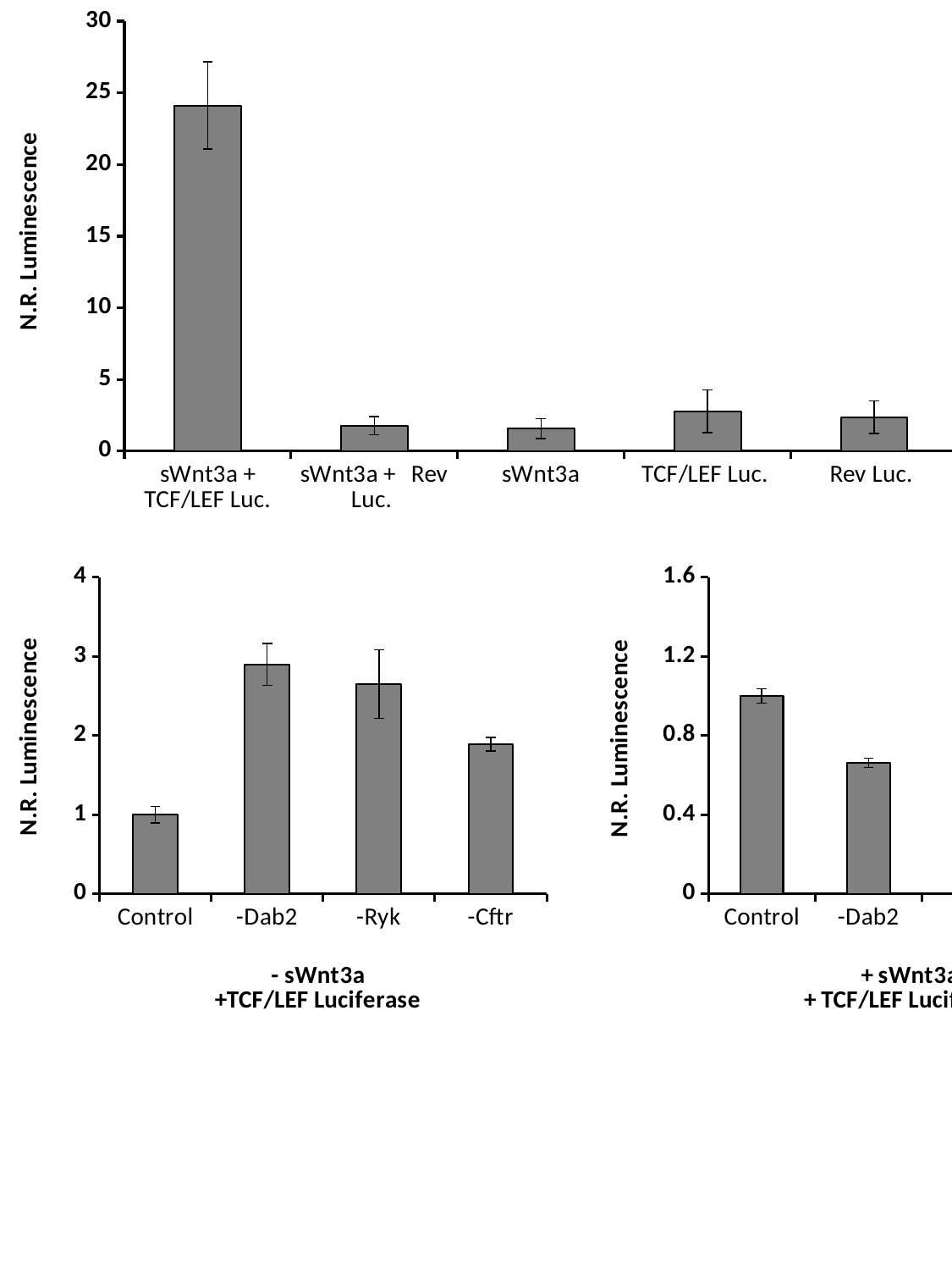
In the bottom-left chart, is the value for -Dab2 greater or less than 2? greater In the top chart, is the value for TCF/LEF Luc. greater or less than 5? less What kind of chart is the top chart? bar chart In the top chart, is the value for sWnt3a + TCF/LEF Luc. greater or less than 20? greater In the top chart, which category has the highest N.R. Luminescence? sWnt3a + TCF/LEF Luc. How many categories are shown on the x axis of the top chart? 5 In the bottom-left chart, which is larger, the value for -Dab2 or the value for -Cftr? -Dab2 In the bottom-right chart, which is larger, the value for Control or the value for -Dab2? Control In the bottom-left chart, which category has the lowest N.R. Luminescence? Control How many categories are shown on the x axis of the bottom-left chart? 4